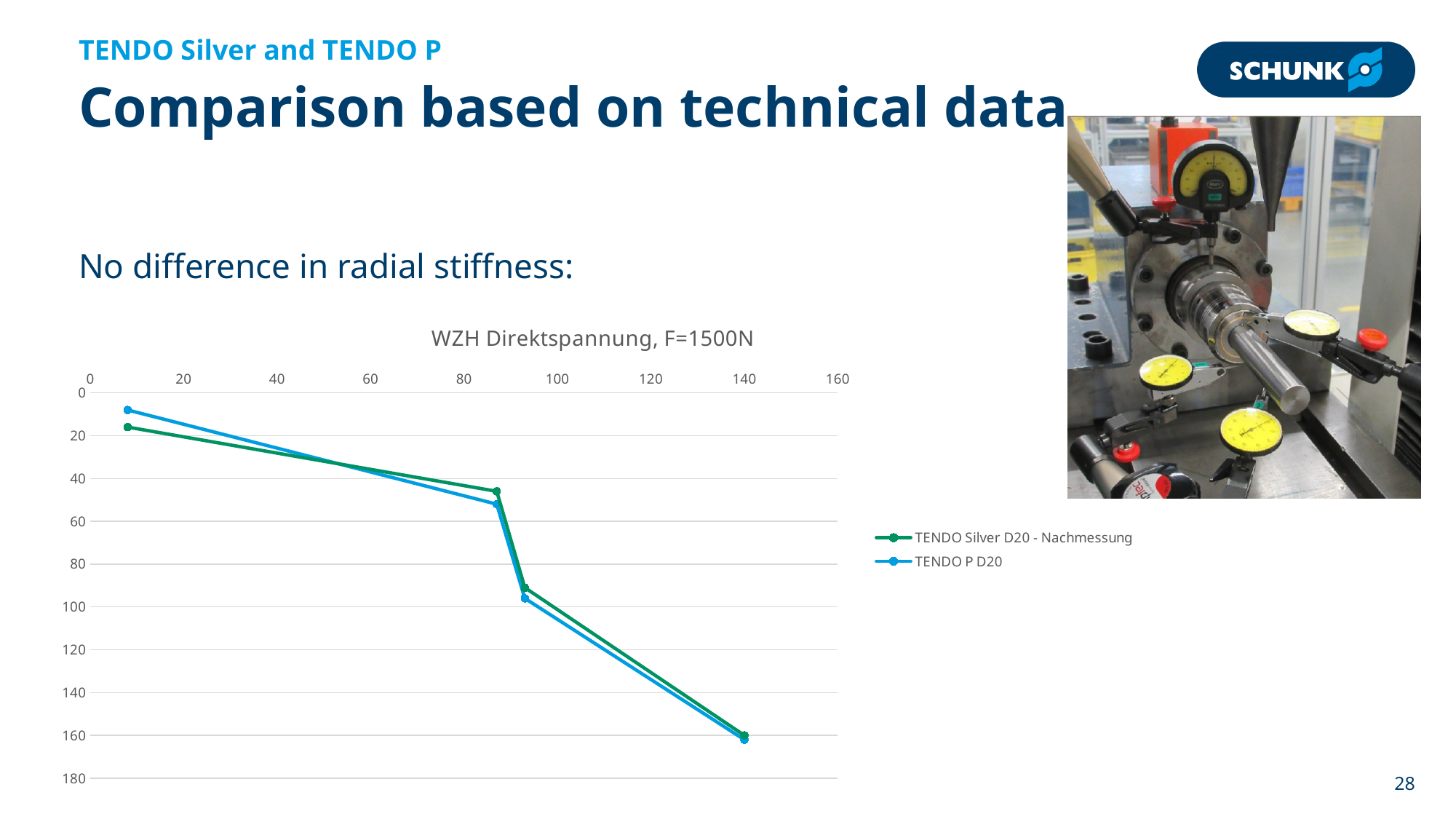
Is the value of the TENDO P D20 series at its last point (around x=140) greater or less than 140? greater At the first data point (near x=10), which series has the larger plotted value, TENDO Silver D20 - Nachmessung or TENDO P D20? TENDO Silver D20 - Nachmessung How many series does the legend of the chart list? 2 What kind of chart is shown on the slide? line chart Do the plotted values for TENDO Silver D20 - Nachmessung increase or decrease as the x-axis value increases? increase What is the highest value shown on the vertical axis of the chart? 180 Is the value of the TENDO P D20 series at its third point (around x=95) greater or less than 80? greater How many data points are plotted for the TENDO P D20 series? 4 What is the title of the chart? WZH Direktspannung, F=1500N Is the value of the TENDO Silver D20 - Nachmessung series at its second point (around x=85) greater or less than 60? less Which series is drawn in blue in the chart? TENDO P D20